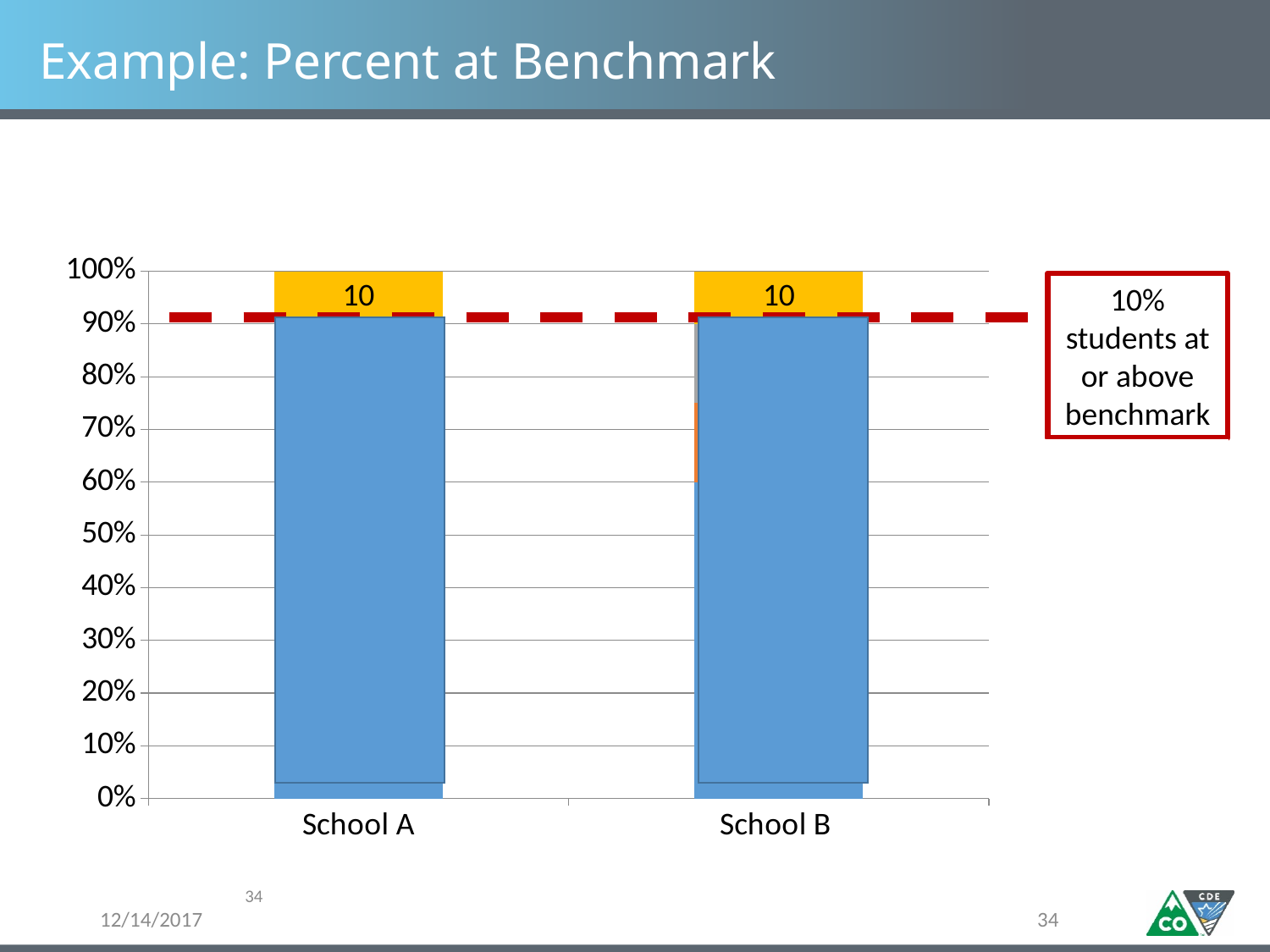
What value is printed on the yellow segment of the School B bar? 10 What value is printed on the yellow segment of the School A bar? 10 At what axis value does the top of the School A stacked bar end? 100% What is the title of the slide? Example: Percent at Benchmark What is the highest value shown on the y axis? 100% How many schools (categories) are shown on the x axis? 2 At what axis value does the top of the School B stacked bar end? 100% Is the top of the blue segment for School B greater or less than 50%? greater What kind of chart is shown on the slide? bar chart Is the top of the blue segment for School A greater or less than 80%? greater What does the red-bordered text box next to the chart say? 10% students at or above benchmark Which category is listed first on the x axis? School A